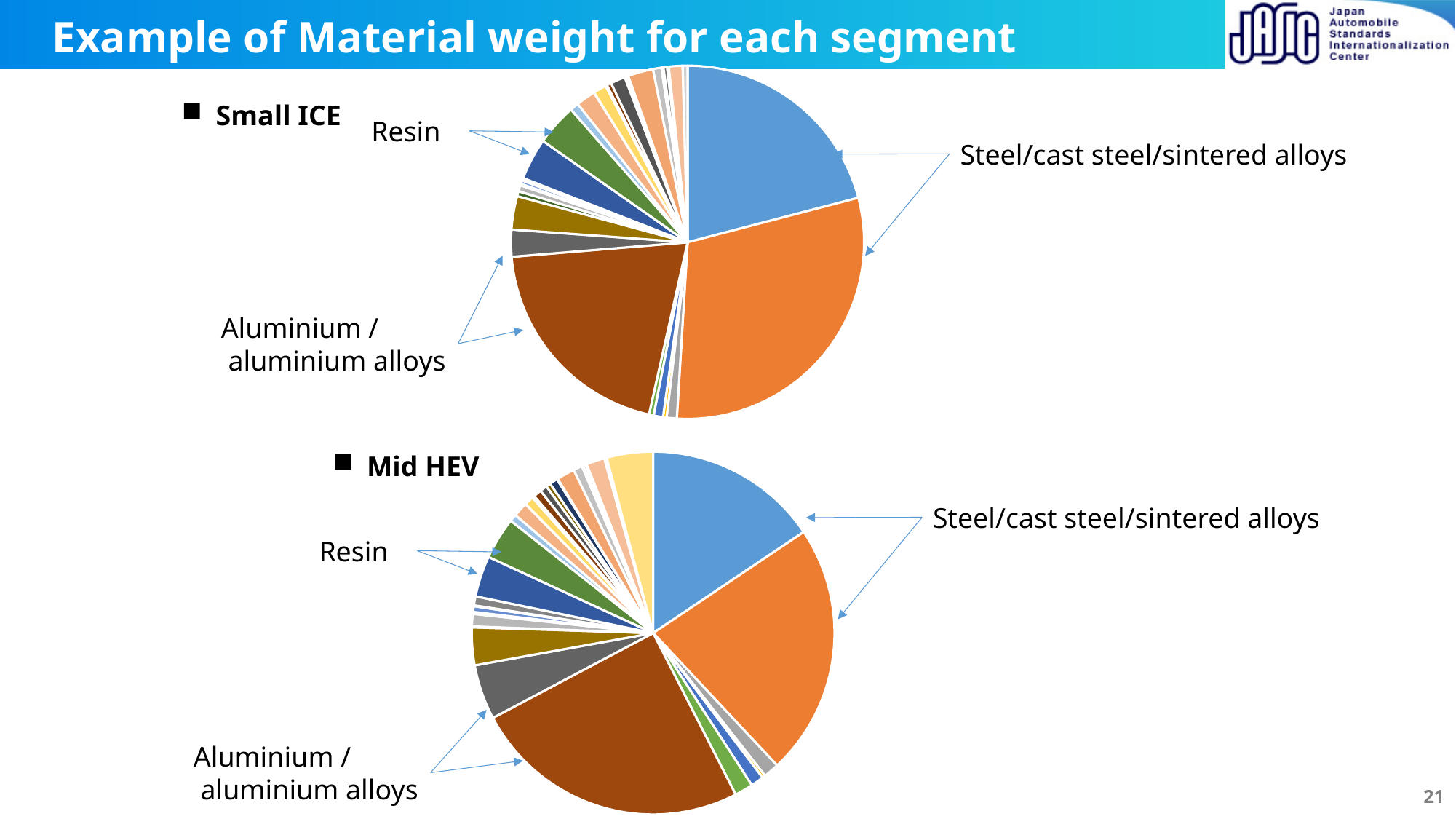
In the Small ICE pie chart, which is larger: the share of Aluminium / aluminium alloys or the share of Resin? Aluminium / aluminium alloys What kind of chart is used for the Small ICE segment? Pie chart In the Mid HEV pie chart, which is larger: the share of Steel/cast steel/sintered alloys or the share of Aluminium / aluminium alloys? Steel/cast steel/sintered alloys Which two vehicle segments are the pie charts on the slide about? Small ICE and Mid HEV What kind of chart is used for the Mid HEV segment? Pie chart Which material group is labelled on the right-hand side of both pie charts? Steel/cast steel/sintered alloys How many pie charts are shown on the slide? 2 In the Small ICE pie chart, which labelled material group has the largest share: Steel/cast steel/sintered alloys, Aluminium / aluminium alloys, or Resin? Steel/cast steel/sintered alloys In the Mid HEV pie chart, which labelled material group has the smallest share: Steel/cast steel/sintered alloys, Aluminium / aluminium alloys, or Resin? Resin